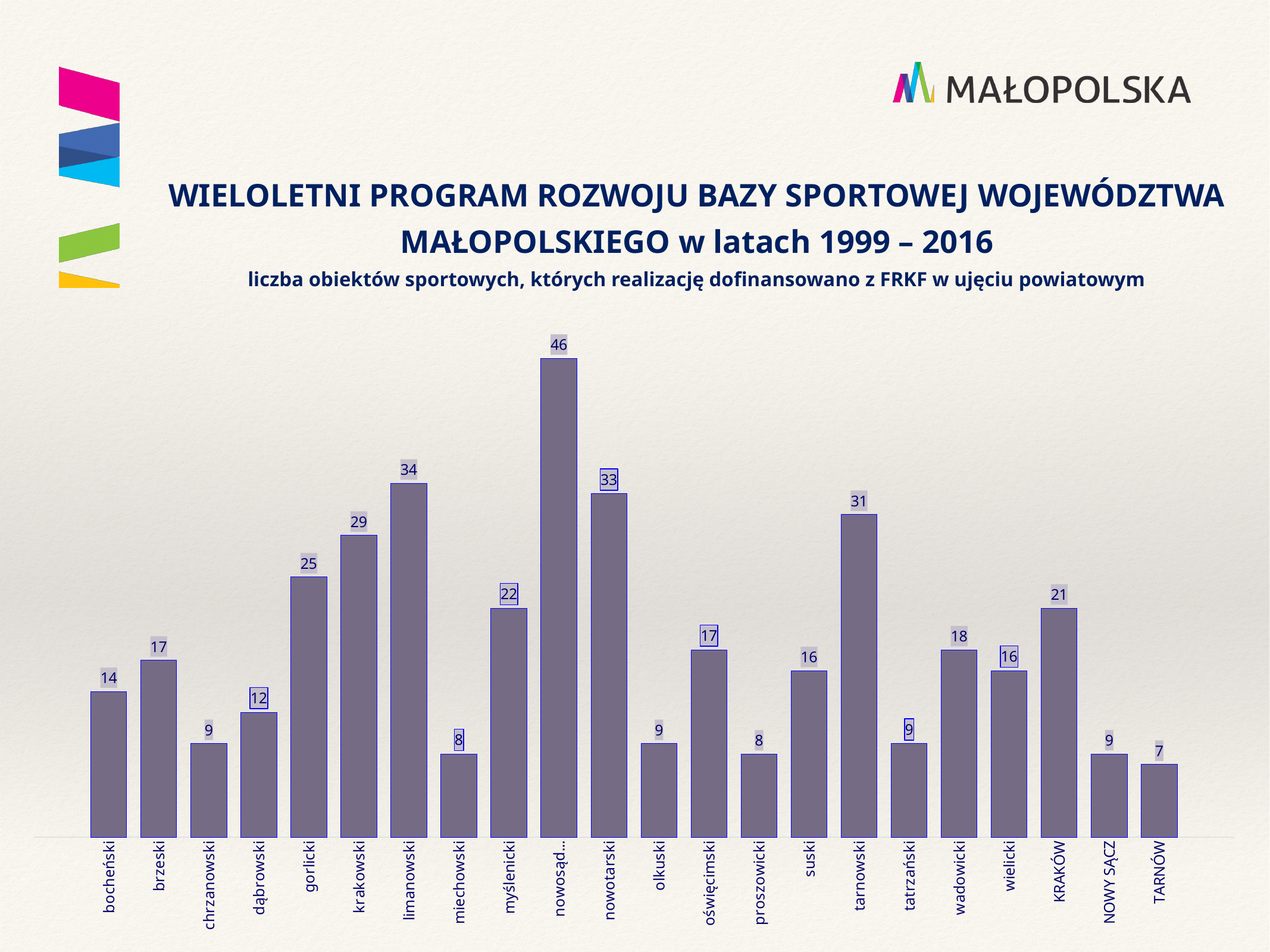
What is the subtitle printed below the main title of the slide? liczba obiektów sportowych, których realizację dofinansowano z FRKF w ujęciu powiatowym Which is larger, the value for brzeski or the value for suski? brzeski What is the value for KRAKÓW? 21 Which category has the lowest value? TARNÓW Which is larger, the value for dąbrowski or the value for wielicki? wielicki How many categories are shown on the x axis? 22 What is the difference between the values for krakowski and wadowicki? 11 What is the difference between the values for nowotarski and gorlicki? 8 What kind of chart is shown on the slide? bar chart What is the value for tarnowski? 31 What is the value for myślenicki? 22 What is the value for limanowski? 34